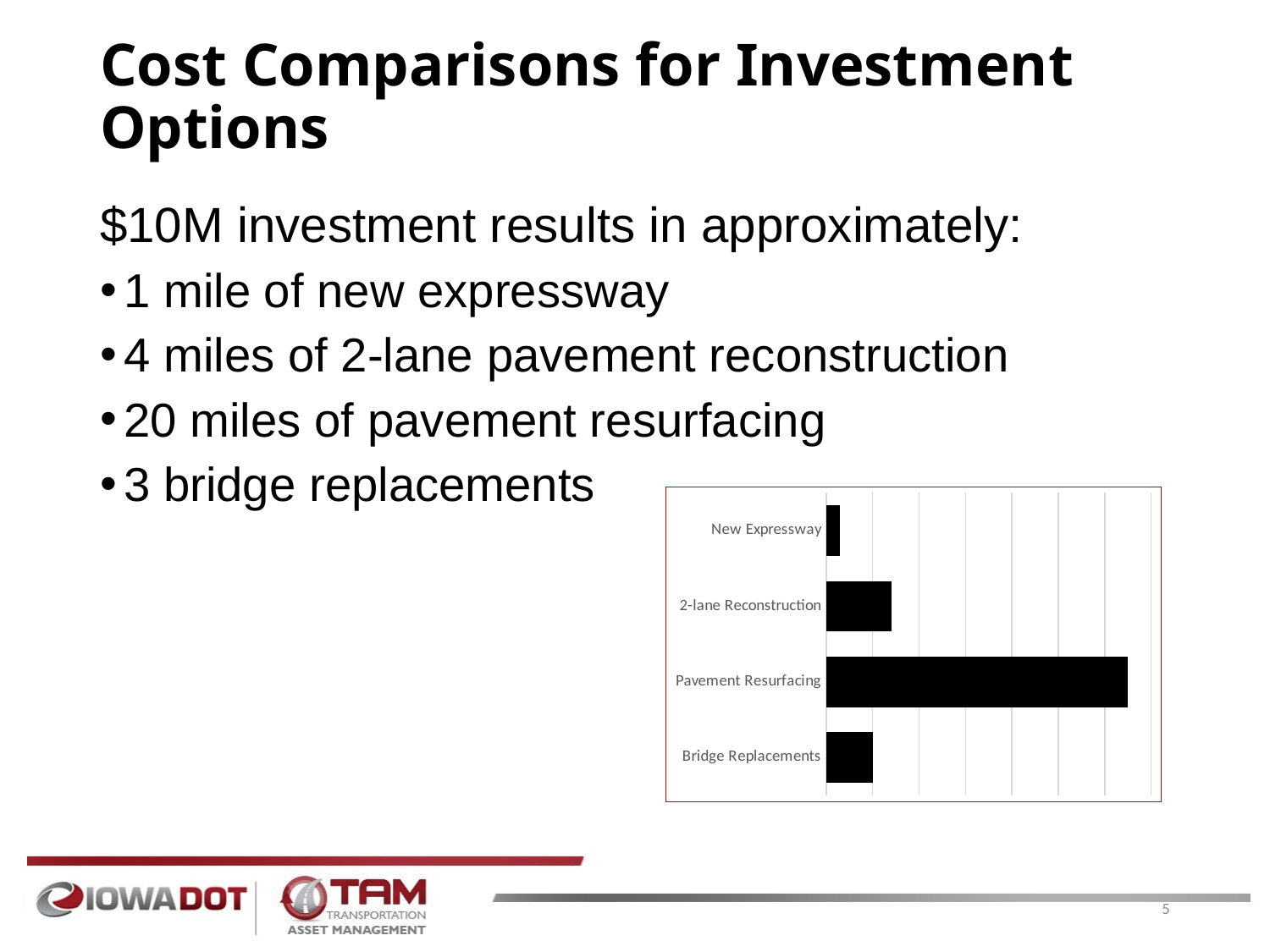
Which category has the shortest bar in the chart? New Expressway What colour are the bars in the chart? Black How many categories are shown in the chart? 4 Which bar is shorter, Pavement Resurfacing or Bridge Replacements? Bridge Replacements Are the bars in the chart horizontal or vertical? Horizontal Which bar is longer, Bridge Replacements or New Expressway? Bridge Replacements Which category has the longest bar in the chart? Pavement Resurfacing What kind of chart is shown on the slide? Bar chart Which bar is longer, Pavement Resurfacing or 2-lane Reconstruction? Pavement Resurfacing Which category is listed at the top of the chart? New Expressway